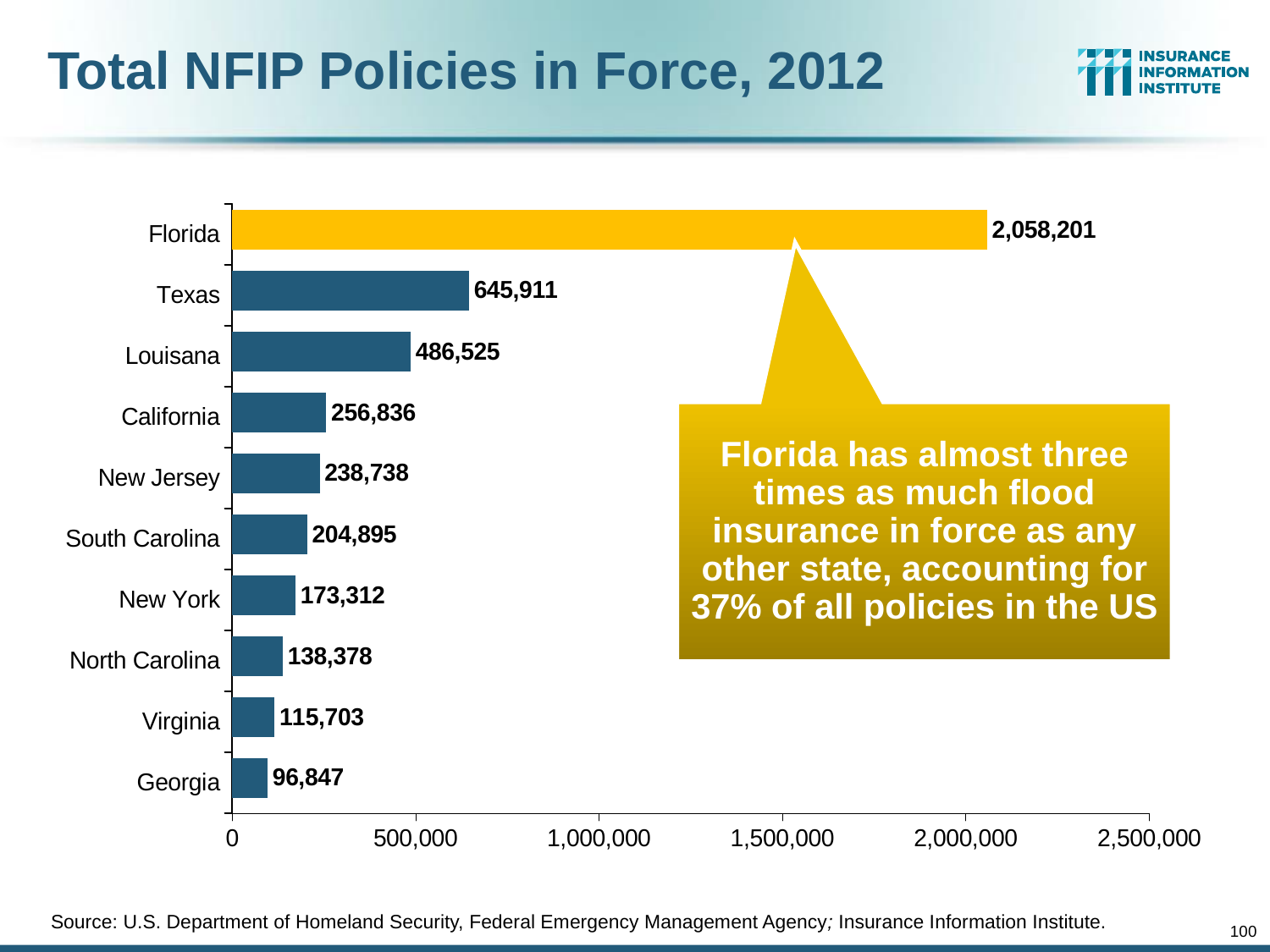
How many states are shown in the chart? 10 Which state has more NFIP policies in force, California or New Jersey? California According to the callout, what share of all US policies does Florida account for? 37% What kind of chart is shown on the slide? Bar chart What is the difference between the number of policies in Texas and Louisiana? 159,386 Which state has the highest number of NFIP policies in force? Florida Is the value for Texas greater or less than 500,000? greater What is the title of the slide? Total NFIP Policies in Force, 2012 What is the number of NFIP policies in force for Florida? 2,058,201 Which state has the lowest number of NFIP policies in force? Georgia What is the number of NFIP policies in force for Louisiana? 486,525 What is the number of NFIP policies in force for North Carolina? 138,378